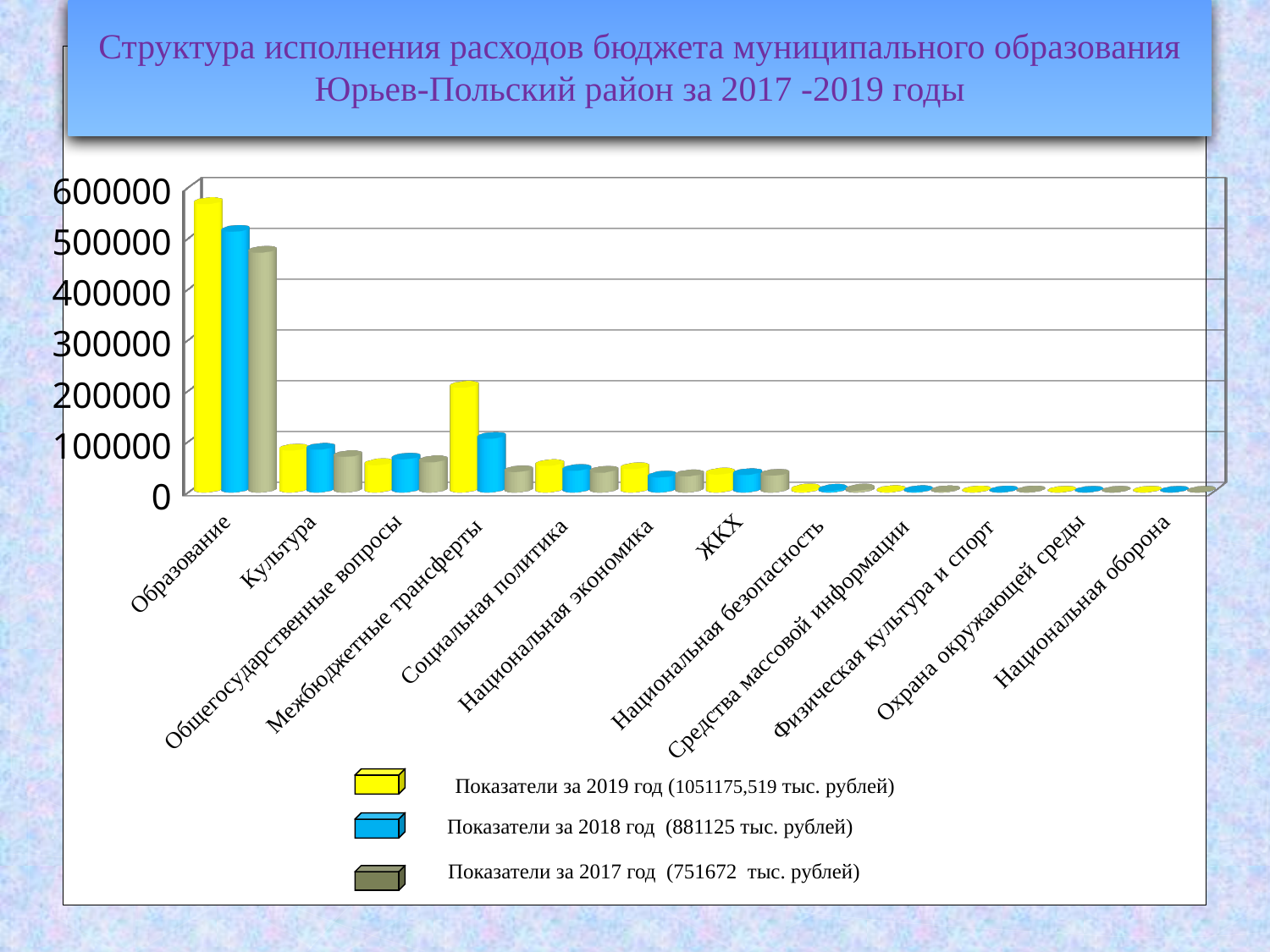
Is the value for Образование in Показатели за 2019 год greater or less than 500000? greater Which category has the highest value for Показатели за 2017 год? Образование Is the value for Культура in Показатели за 2019 год greater or less than 200000? less What total amount does the legend give for Показатели за 2019 год? 1051175,519 тыс. рублей Do the values for Показатели за 2019 год generally rise or fall moving from left to right along the x axis? fall Which category has the highest value for Показатели за 2019 год? Образование For Межбюджетные трансферты, which is larger: Показатели за 2019 год or Показатели за 2018 год? Показатели за 2019 год What kind of chart is shown on the slide? bar chart Is the value for Образование in Показатели за 2017 год greater or less than 500000? less How many series does the legend list? 3 How many expenditure categories are shown along the x axis? 12